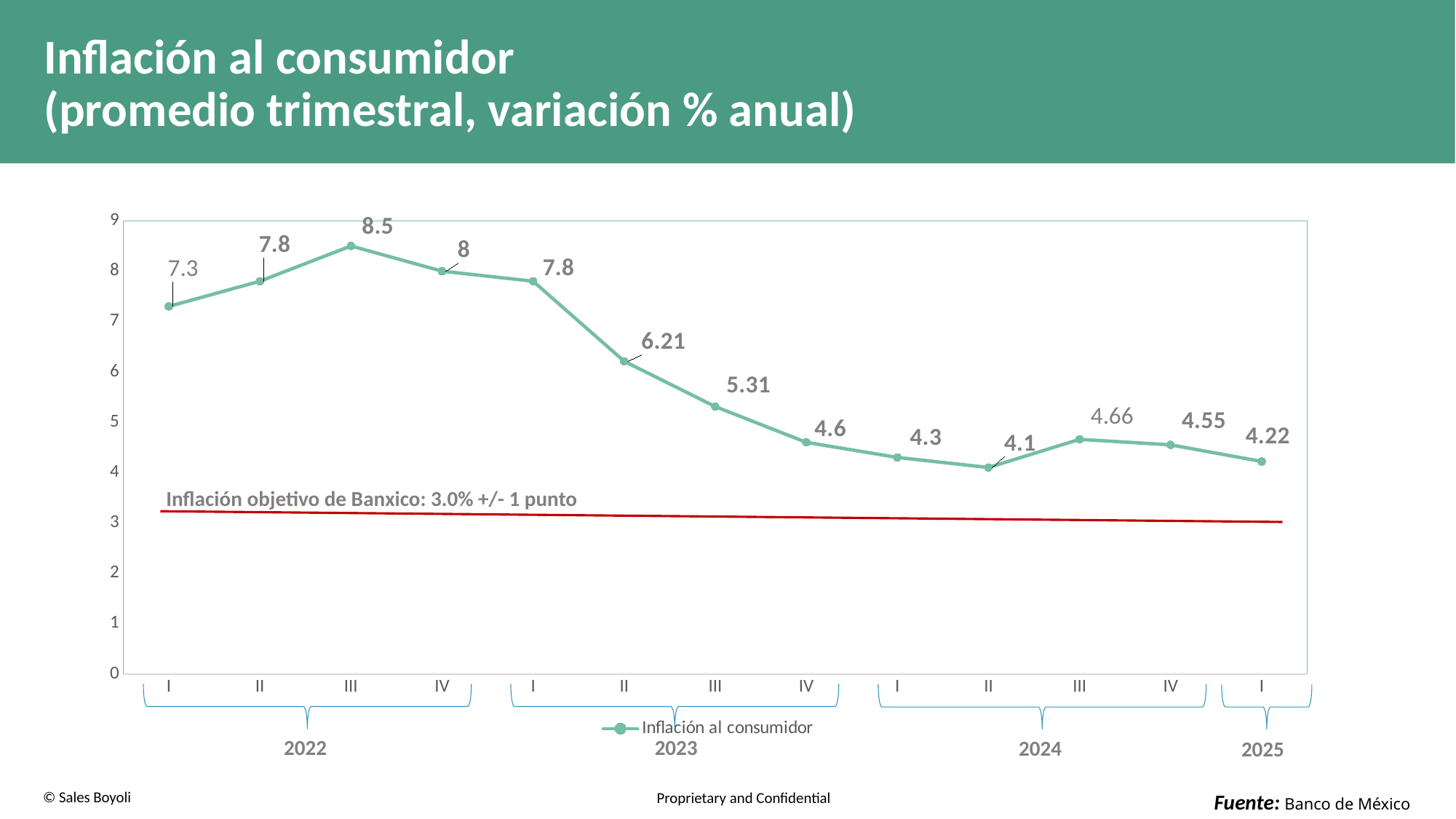
Which quarter has the lowest value? II 2024 Is the value for quarter III of 2023 greater or less than 6? less What is the value for quarter IV of 2024? 4.55 What is the value for quarter II of 2023? 6.21 What is the difference between the values for quarter III of 2022 and quarter I of 2025? 4.28 What kind of chart is shown? line chart What is the value for quarter III of 2022? 8.5 What is the value for quarter I of 2025? 4.22 How many data points are plotted on the line? 13 Which is larger, the value for quarter III of 2024 or quarter IV of 2024? III 2024 Which quarter has the highest value? III 2022 Do the values rise or fall from quarter I of 2023 to quarter II of 2024? fall